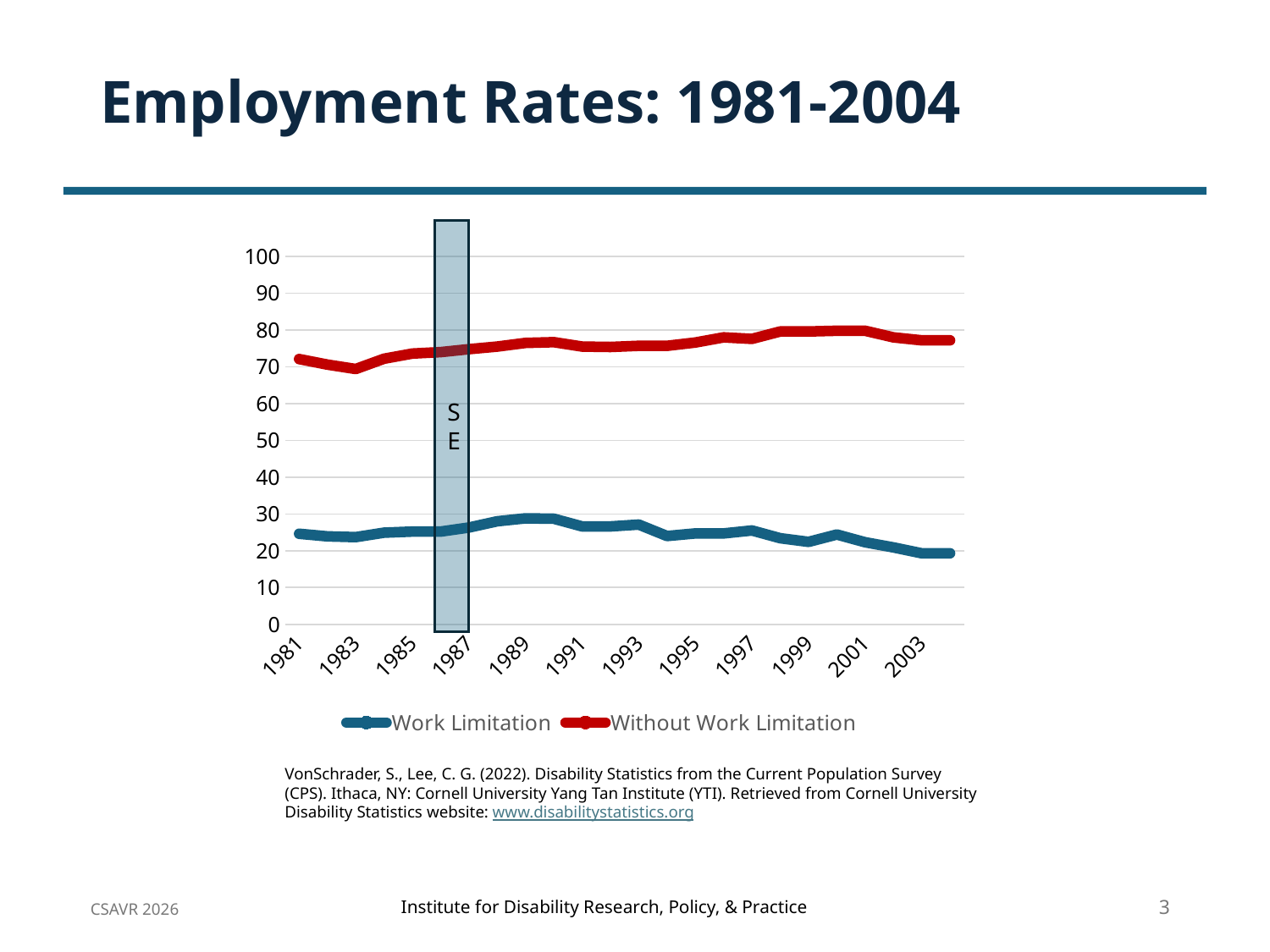
What is the title of the slide containing the chart? Employment Rates: 1981-2004 Is the value for Work Limitation in 1989 greater or less than 20? greater Is the value for Without Work Limitation in 2003 greater or less than 70? greater What kind of chart is shown on the slide? Line chart What are the two series named in the legend? Work Limitation and Without Work Limitation How many series does the legend list? 2 How many year labels are shown on the x axis? 12 Is the value for Work Limitation in 1981 greater or less than 30? less Does the Work Limitation line rise or fall between 1997 and 2004? Fall Which series has the higher employment rate throughout the period shown? Without Work Limitation